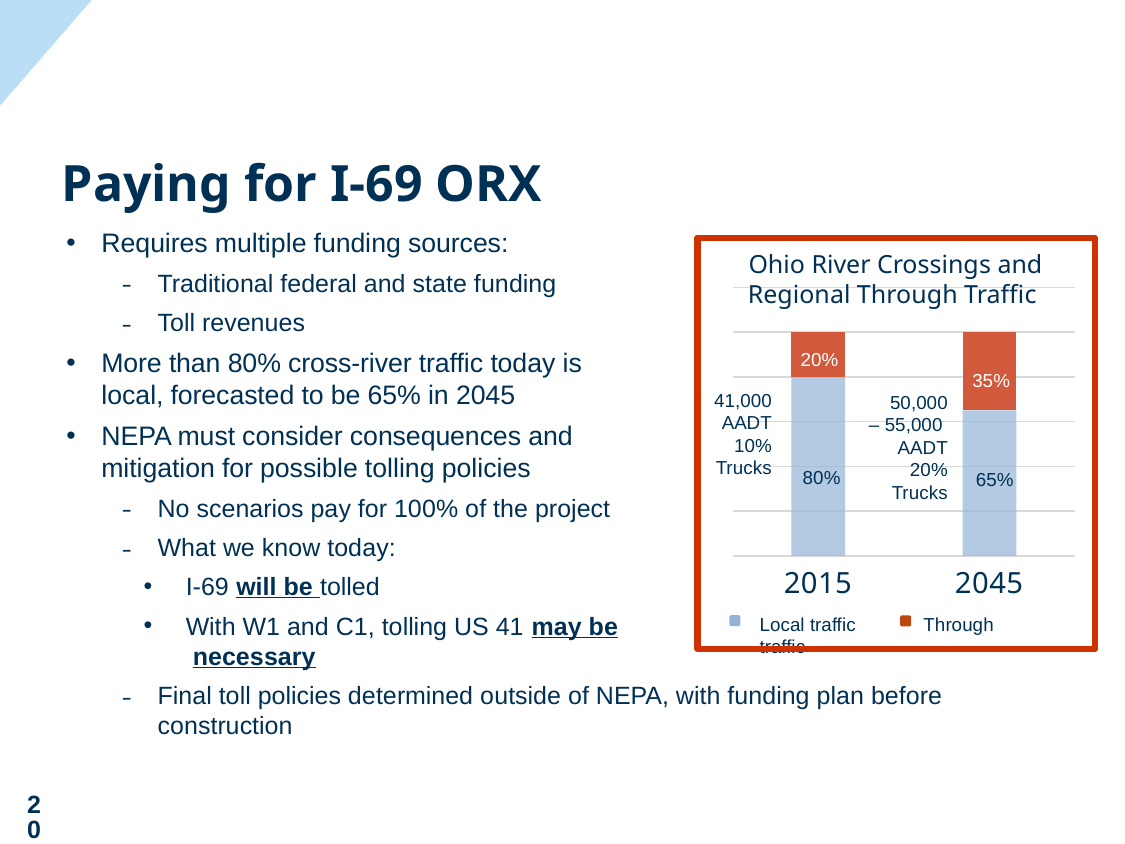
What share of traffic is through traffic in 2015? 20% Which year has the larger through traffic share, 2015 or 2045? 2045 How many series does the legend list? 2 What AADT is annotated next to the 2015 bar? 41,000 AADT How many categories (years) are shown on the x axis? 2 Does the local traffic share rise or fall from 2015 to 2045? Fall What share of traffic is local traffic in 2045? 65% What share of traffic is local traffic in 2015? 80% What share of traffic is through traffic in 2045? 35% By how many percentage points does the local traffic share fall from 2015 to 2045? 15 percentage points What is the chart's title? Ohio River Crossings and Regional Through Traffic What kind of chart is shown on the slide? Stacked bar chart